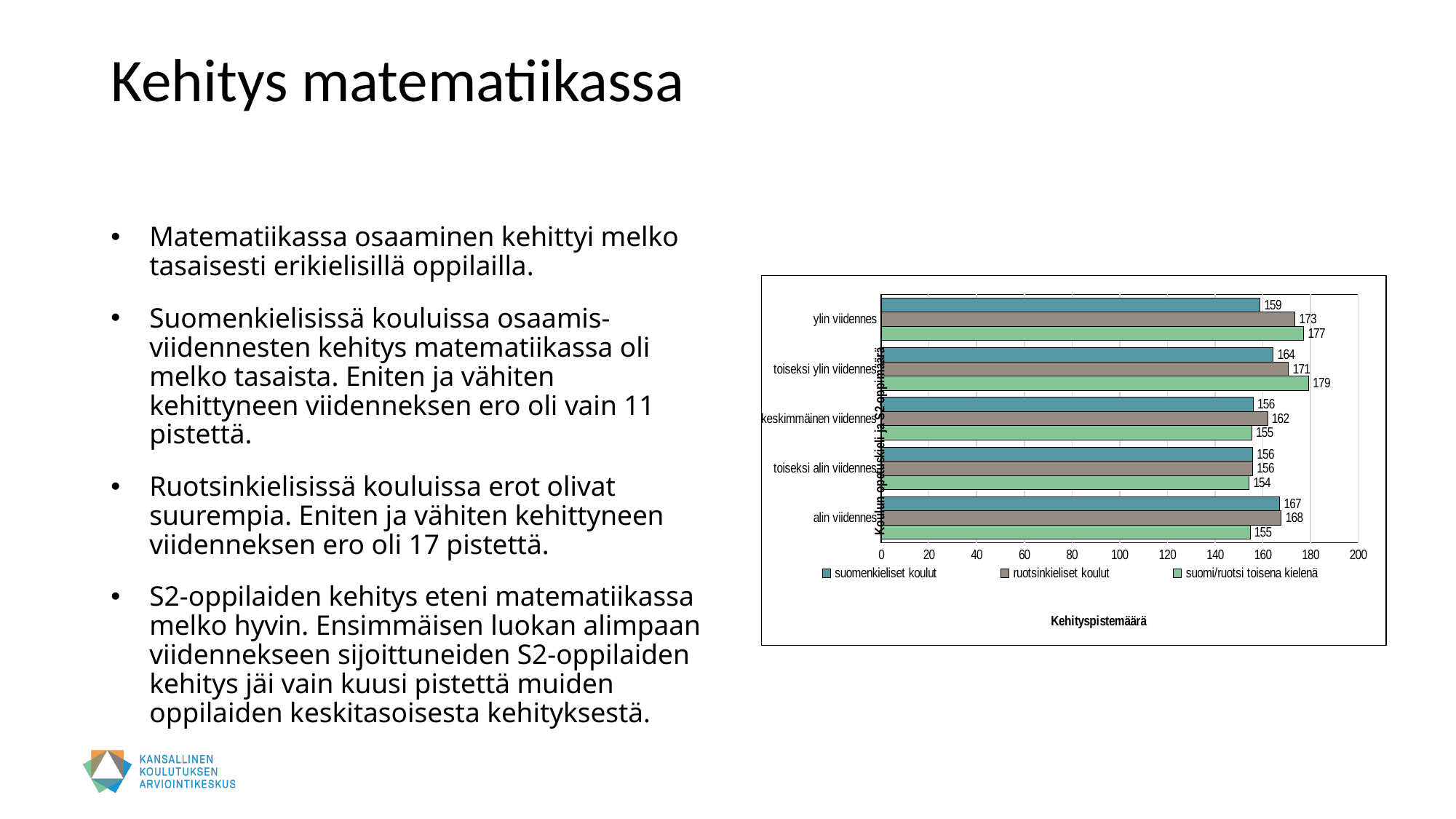
What is the difference between the ruotsinkieliset koulut and suomenkieliset koulut values in the ylin viidennes category? 14 What is the value for suomi/ruotsi toisena kielenä in the toiseksi ylin viidennes category? 179 What type of chart is shown on the slide? bar chart In the keskimmäinen viidennes category, which series has the larger value: ruotsinkieliset koulut or suomi/ruotsi toisena kielenä? ruotsinkieliset koulut What is the title of the horizontal axis of the chart? Kehityspistemäärä What is the value for suomenkieliset koulut in the ylin viidennes category? 159 How many series does the legend list? 3 Which category has the highest value for suomenkieliset koulut? alin viidennes What is the value for ruotsinkieliset koulut in the alin viidennes category? 168 How many categories are shown on the vertical axis of the chart? 5 Is the value for suomi/ruotsi toisena kielenä in the ylin viidennes category greater or less than 160? greater Which category has the lowest value for suomi/ruotsi toisena kielenä? toiseksi alin viidennes